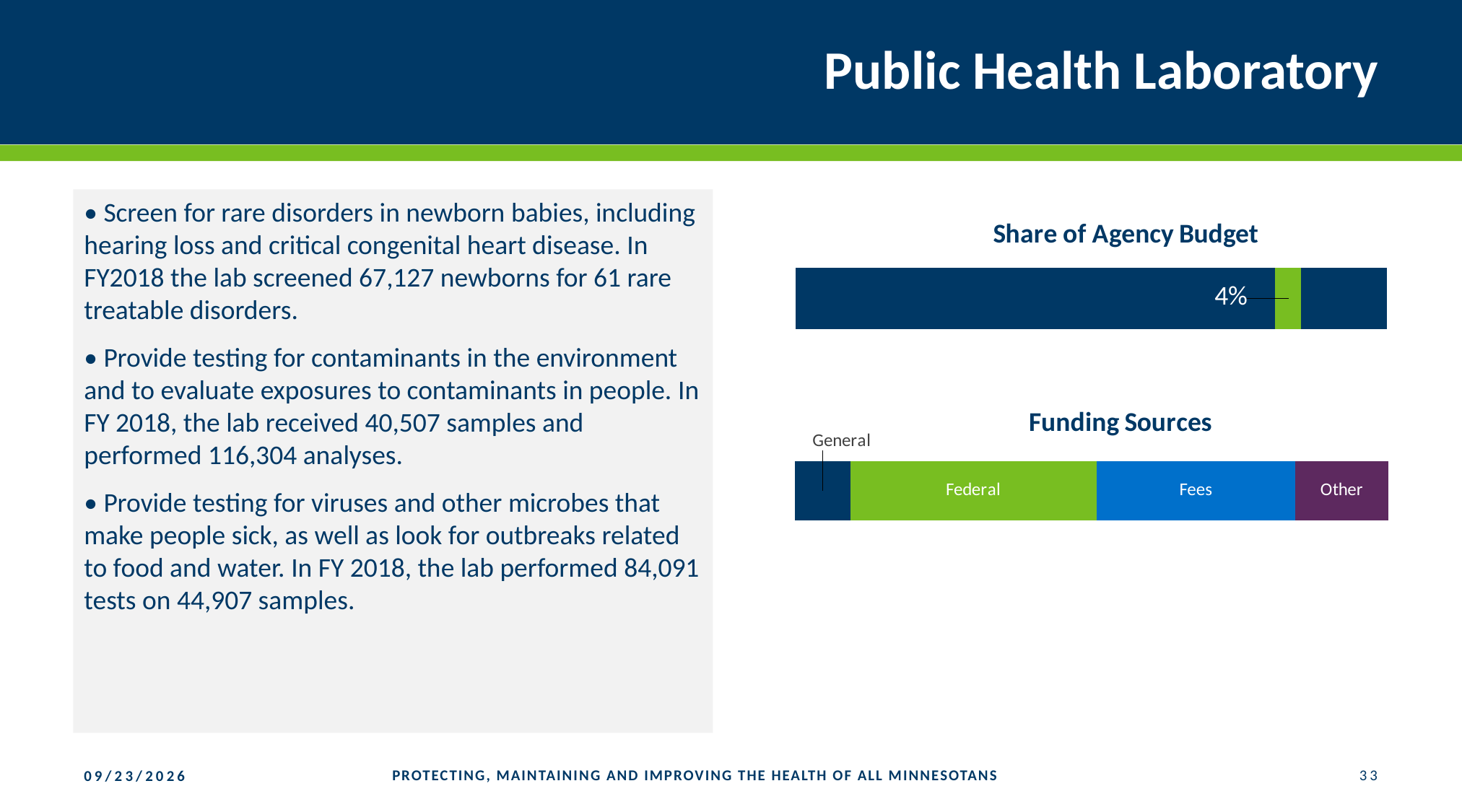
In the 'Funding Sources' chart, which segment is larger, Federal or Fees? Federal What kind of chart is the 'Funding Sources' chart? bar chart What is the title of the lower chart on the slide? Funding Sources In the 'Funding Sources' chart, which segment is larger, Fees or Other? Fees What kind of chart is the 'Share of Agency Budget' chart? bar chart In the 'Funding Sources' chart, which funding source has the largest segment? Federal In the 'Funding Sources' chart, which funding source has the smallest segment? General In the 'Funding Sources' chart, what colour is the Federal segment? green In the 'Share of Agency Budget' chart, what percentage is shown by the data label on the highlighted green segment? 4% In the 'Funding Sources' chart, how many funding source segments are shown? 4 In the 'Funding Sources' chart, which segment is larger, General or Other? Other